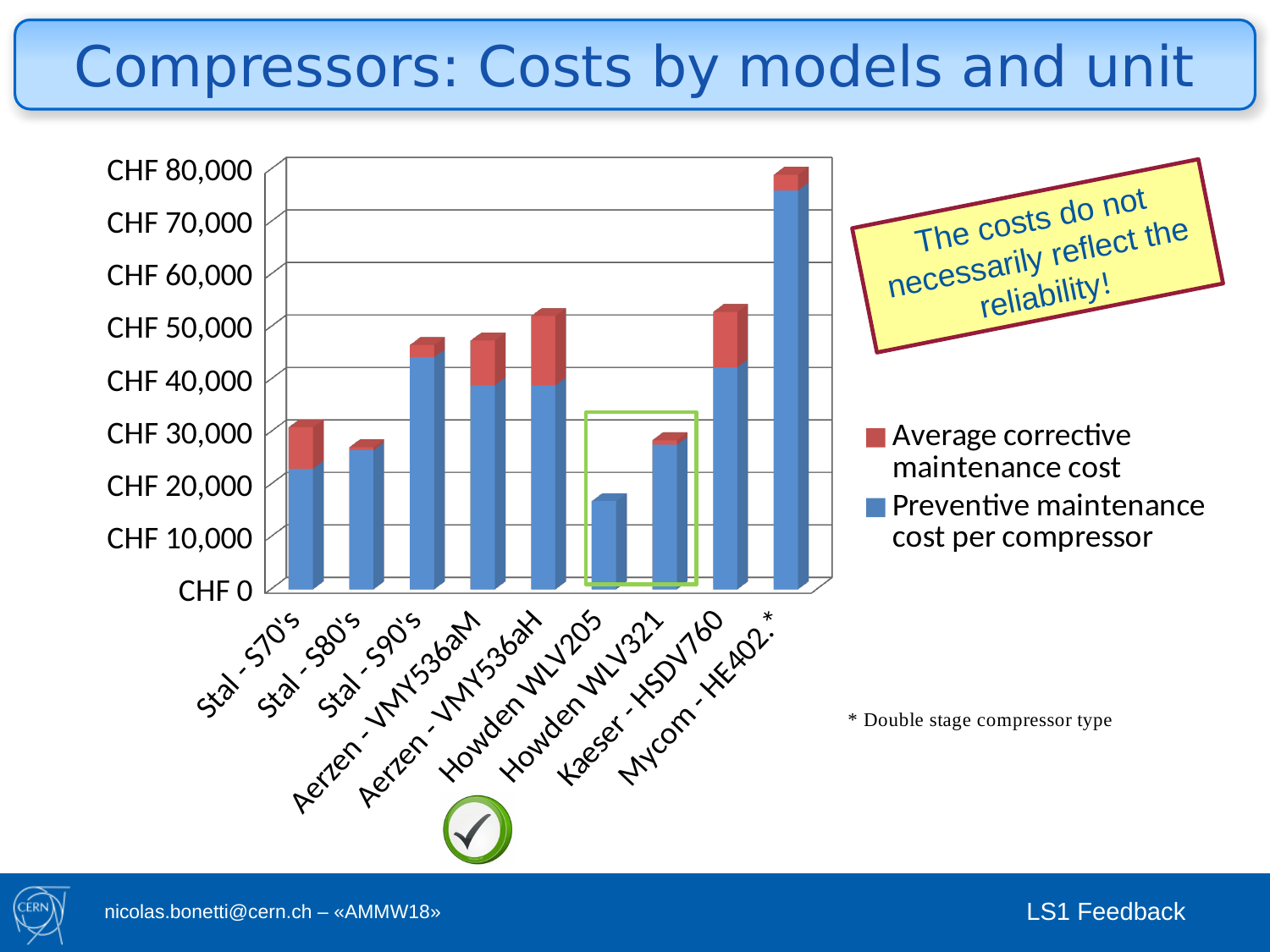
Which series in the chart is shown in red? Average corrective maintenance cost What kind of chart is shown on the slide? bar chart How many compressor models are shown on the x axis of the chart? 9 Which has the larger total cost, Stal - S70's or Stal - S90's? Stal - S90's Is the total cost for Stal - S80's greater or less than CHF 30,000? less Which has the larger total cost, Howden WLV205 or Howden WLV321? Howden WLV321 How many series does the chart legend list? 2 Is the total cost for Stal - S90's greater or less than CHF 40,000? greater Which compressor model has the highest total cost in the chart? Mycom - HE402.* Is the total cost for Mycom - HE402.* greater or less than CHF 70,000? greater Which compressor model has the lowest total cost in the chart? Howden WLV205